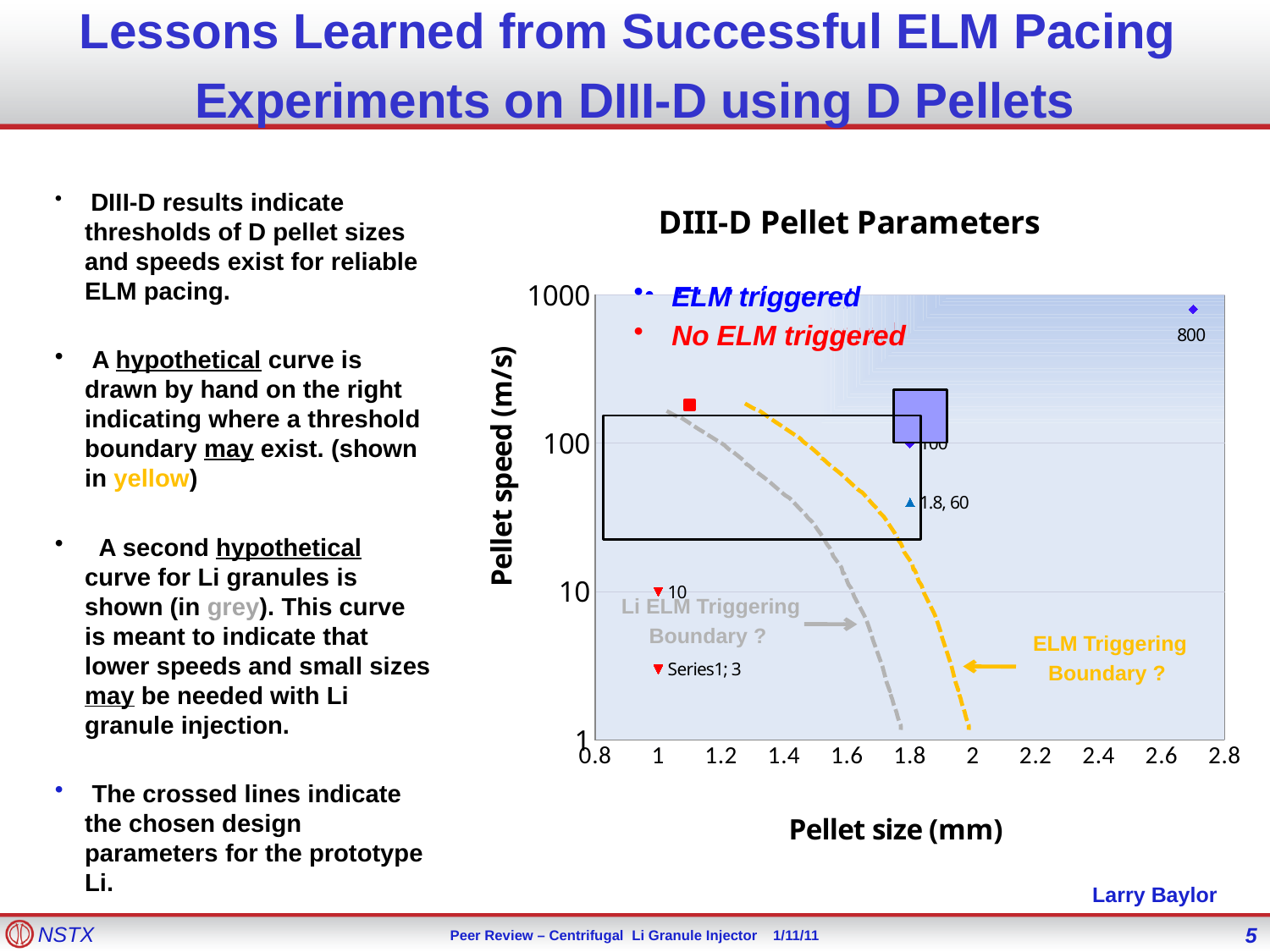
Of the two points labeled "10" and "Series1; 3", which has the larger pellet speed? 10 What is the difference in pellet speed between the point labeled 800 and the point labeled "1.8, 60"? 740 Is the pellet size of the point labeled 800 greater or less than 2.6? greater What is the pellet speed of the data point labeled "1.8, 60"? 60 What kind of chart is shown on the slide? scatter chart What is the title of the chart? DIII-D Pellet Parameters What is the pellet size of the data point labeled "1.8, 60"? 1.8 Is the pellet speed of the red square point near pellet size 1.1 greater or less than 100? greater What is the lowest pellet speed value labeled on the chart? 3 What is the maximum value shown on the pellet speed axis? 1000 What is the highest pellet speed value labeled on the chart? 800 What colour is the dashed curve labeled "ELM Triggering Boundary ?"? yellow